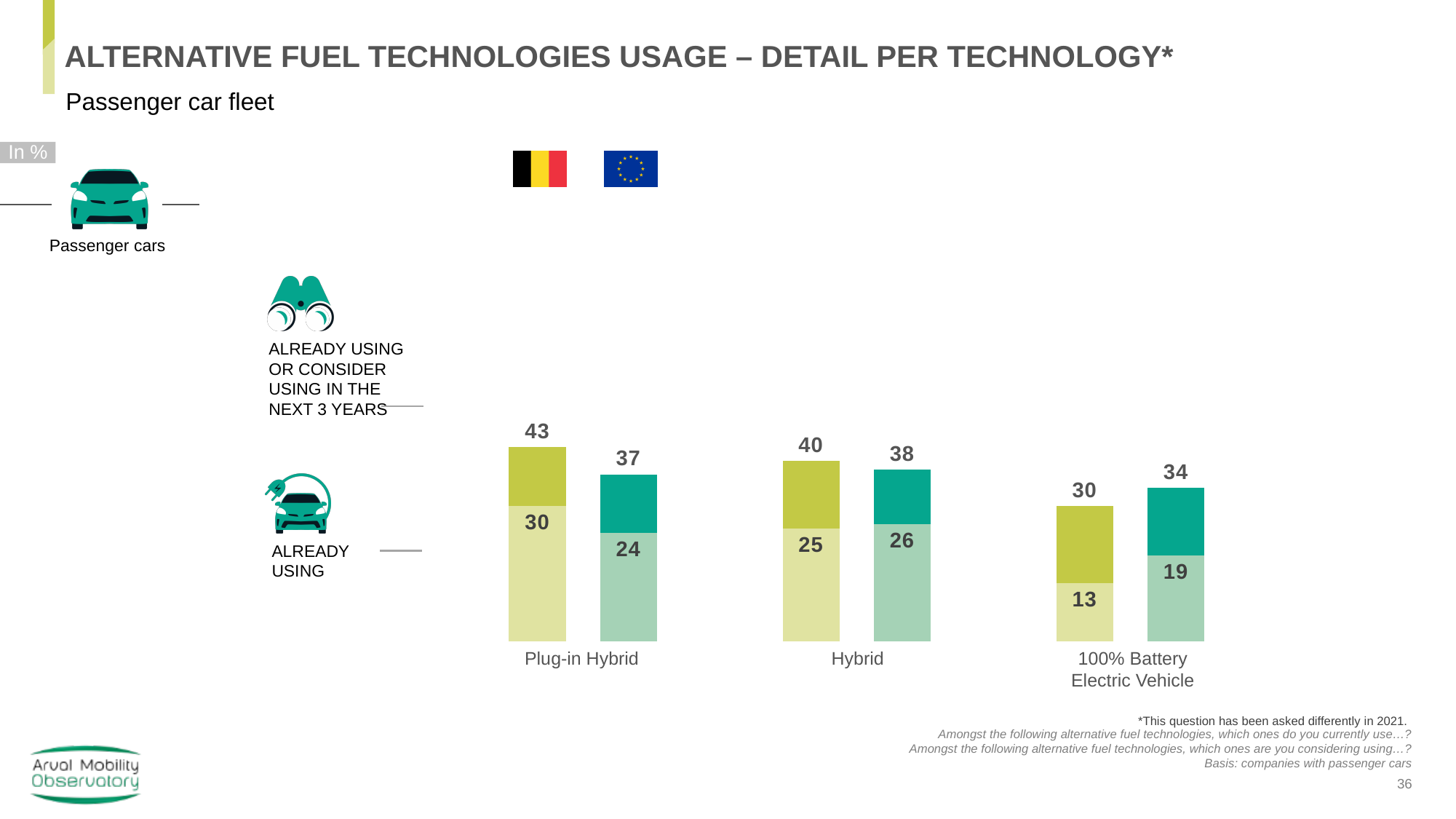
How many technology categories are shown on the chart? 3 What is the 'already using' value for Hybrid in Belgium? 25 What is the 'already using' value for 100% Battery Electric Vehicle in the EU series? 19 Which technology has the highest 'already using or consider using in the next 3 years' value for Belgium? Plug-in Hybrid What is the 'already using or consider using in the next 3 years' value for Plug-in Hybrid in Belgium? 43 What kind of chart is shown on the slide? Bar chart Which technology has the lowest 'already using' value in the EU series? 100% Battery Electric Vehicle For 100% Battery Electric Vehicle, which is larger: the Belgium or the EU 'already using or consider using' value? EU How many series (flags) does the chart compare? 2 In what unit are the chart values expressed? % What is the difference between the Belgium and EU 'already using' values for Plug-in Hybrid? 6 For Hybrid, which is larger: the Belgium or the EU 'already using' value? EU